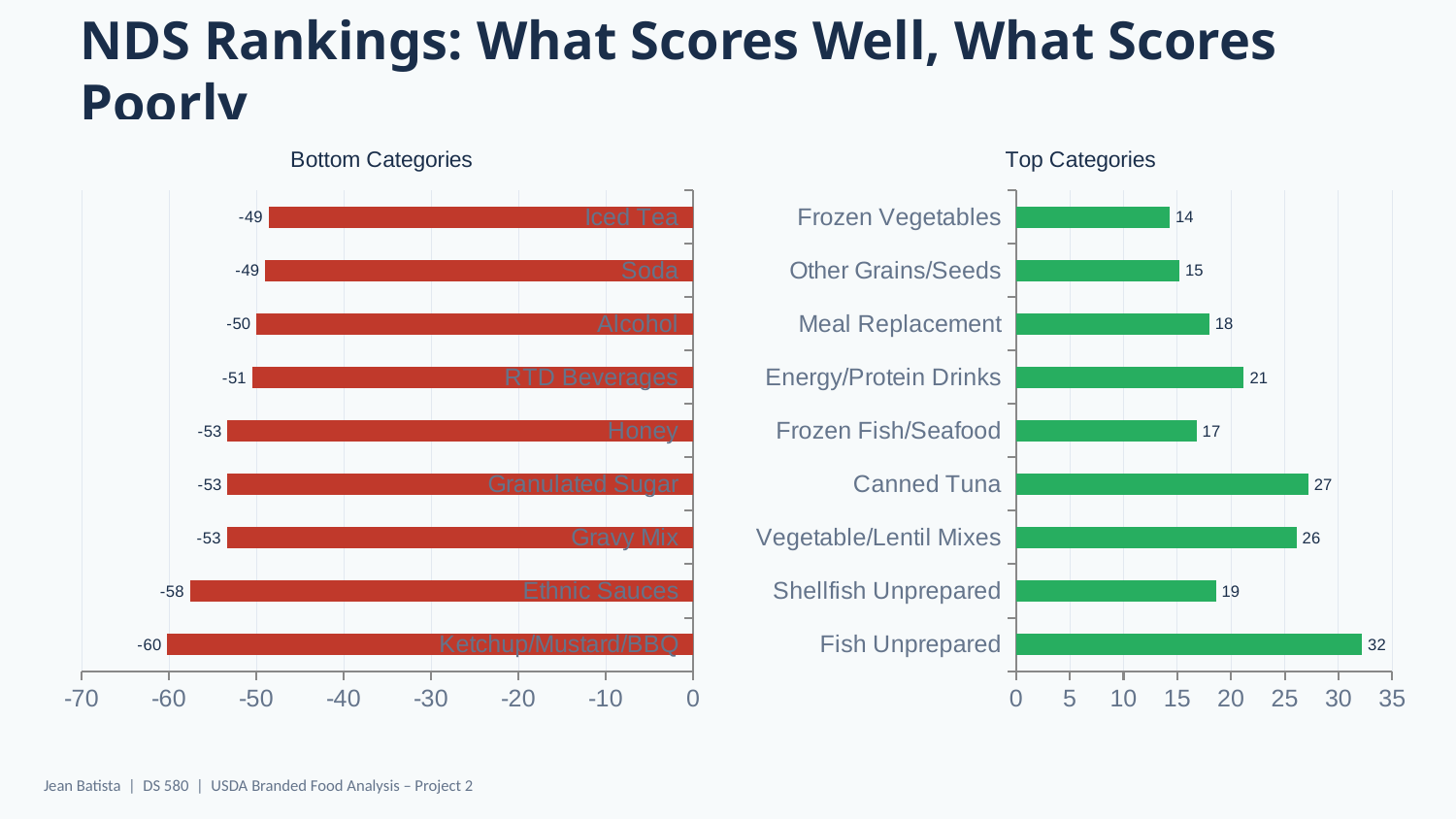
In the Bottom Categories chart, what is the value for Ketchup/Mustard/BBQ? -60 In the Top Categories chart, which category has the lowest value? Frozen Vegetables In the Top Categories chart, which is larger, Energy/Protein Drinks or Shellfish Unprepared? Energy/Protein Drinks In the Top Categories chart, what is the difference between Canned Tuna and Vegetable/Lentil Mixes? 1 In the Bottom Categories chart, what is the difference between the values for Ethnic Sauces and Iced Tea? 9 In the Top Categories chart, is the value for Meal Replacement greater or less than 20? less What colour are the bars in the Bottom Categories chart? Red In the Bottom Categories chart, which category has the lowest value? Ketchup/Mustard/BBQ In the Top Categories chart, which category has the highest value? Fish Unprepared In the Top Categories chart, what is the value for Fish Unprepared? 32 How many categories are shown in the Bottom Categories chart? 9 What type of chart is the Top Categories chart? Bar chart